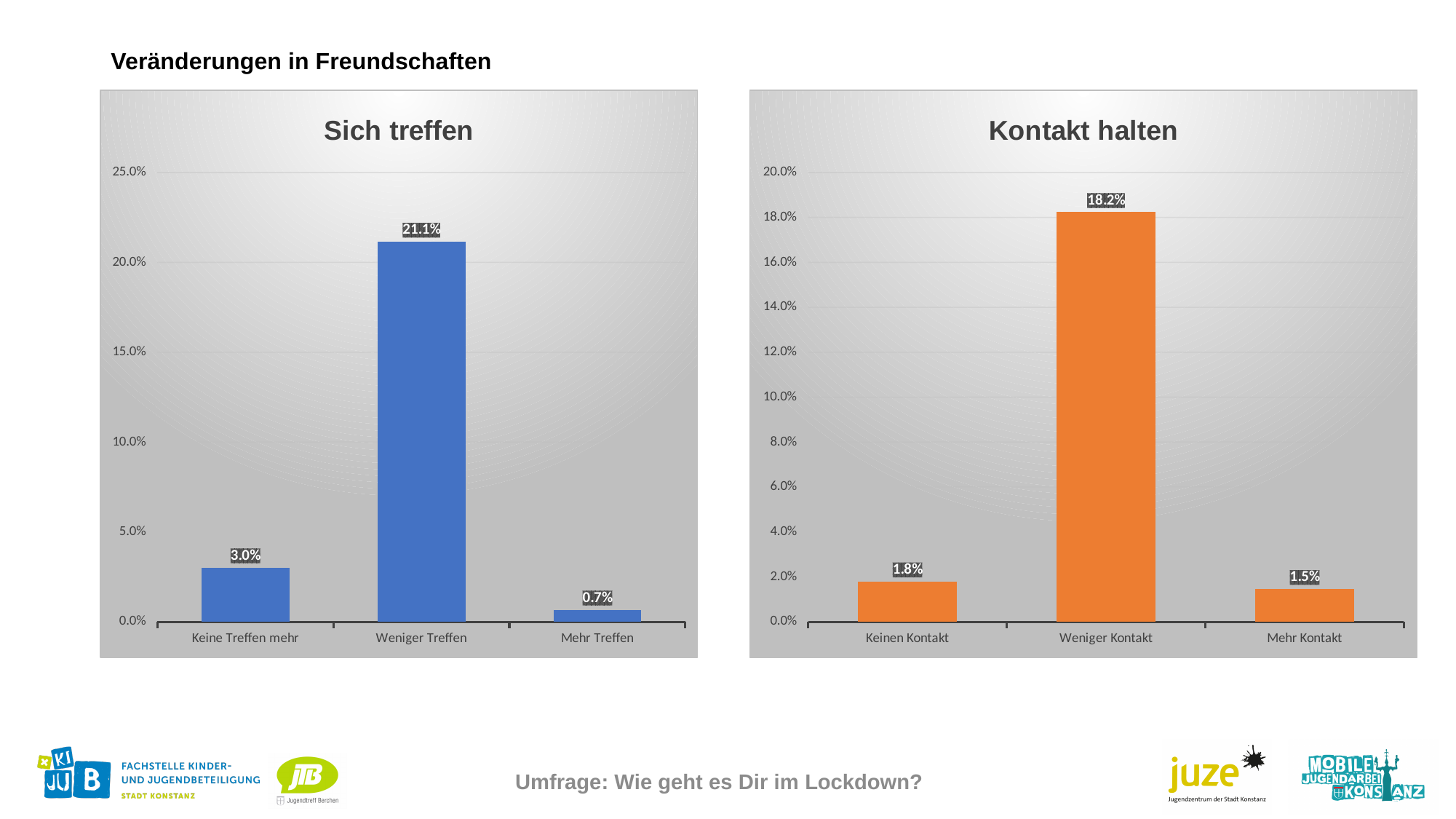
In the 'Kontakt halten' chart, which is larger, Keinen Kontakt or Mehr Kontakt? Keinen Kontakt In the 'Sich treffen' chart, what is the value for Keine Treffen mehr? 3.0% In the 'Sich treffen' chart, is the value for Weniger Treffen greater or less than 20.0%? greater In the 'Sich treffen' chart, what is the difference between Weniger Treffen and Keine Treffen mehr? 18.1% In the 'Kontakt halten' chart, what is the difference between Keinen Kontakt and Mehr Kontakt? 0.3% What colour are the bars in the 'Kontakt halten' chart? Orange How many categories does the 'Kontakt halten' chart show? 3 What kind of chart is the 'Sich treffen' chart? Bar chart In the 'Kontakt halten' chart, which category has the highest value? Weniger Kontakt In the 'Sich treffen' chart, what is the value for Weniger Treffen? 21.1% In the 'Sich treffen' chart, which category has the lowest value? Mehr Treffen In the 'Kontakt halten' chart, what is the value for Mehr Kontakt? 1.5%